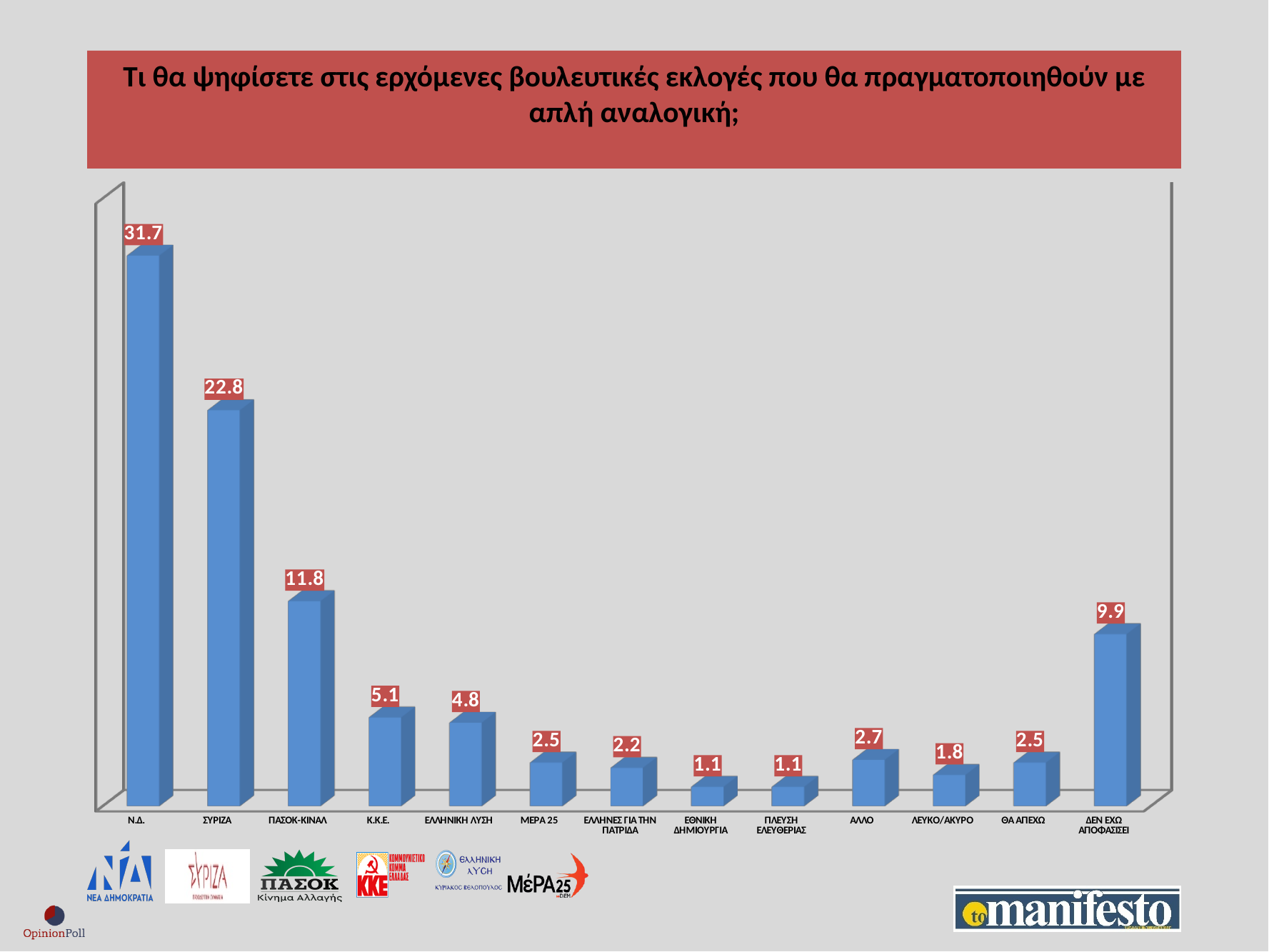
What is the value for Ν.Δ.? 31.7 What is the value for ΔΕΝ ΕΧΩ ΑΠΟΦΑΣΙΣΕΙ? 9.9 What colour are the bars in the chart? Blue What is the value for ΕΛΛΗΝΙΚΗ ΛΥΣΗ? 4.8 What is the value for ΠΑΣΟΚ-ΚΙΝΑΛ? 11.8 Which category has the highest value? Ν.Δ. How many categories are shown on the x axis? 13 What kind of chart is shown on the slide? Bar chart What is the value for ΣΥΡΙΖΑ? 22.8 Which is larger, the value for Κ.Κ.Ε. or the value for ΕΛΛΗΝΙΚΗ ΛΥΣΗ? Κ.Κ.Ε. What is the difference between the values for ΠΑΣΟΚ-ΚΙΝΑΛ and ΔΕΝ ΕΧΩ ΑΠΟΦΑΣΙΣΕΙ? 1.9 What is the difference between the values for Ν.Δ. and ΣΥΡΙΖΑ? 8.9